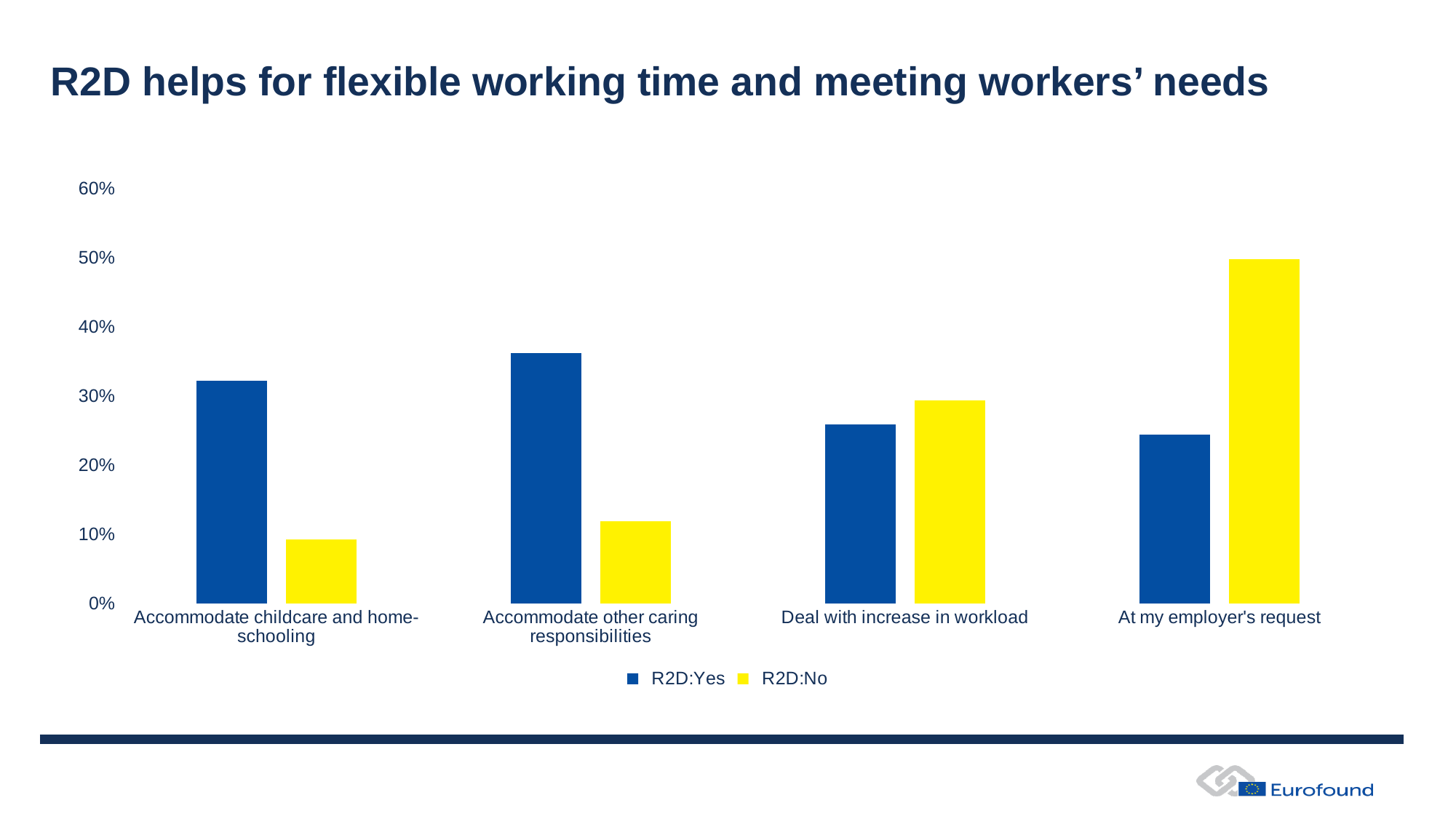
Which category has the highest R2D:No value? At my employer's request How many series does the legend list? 2 Which colour represents the R2D:No series? yellow What kind of chart is shown on the slide? bar chart Is the R2D:No value for 'At my employer's request' greater or less than 40%? greater Which category has the highest R2D:Yes value? Accommodate other caring responsibilities Which category has the lowest R2D:No value? Accommodate childcare and home-schooling Is the R2D:Yes value for 'Accommodate other caring responsibilities' greater or less than 40%? less Is the R2D:Yes value for 'At my employer's request' greater or less than 30%? less For 'Accommodate childcare and home-schooling', which is larger: R2D:Yes or R2D:No? R2D:Yes How many categories are shown on the x axis? 4